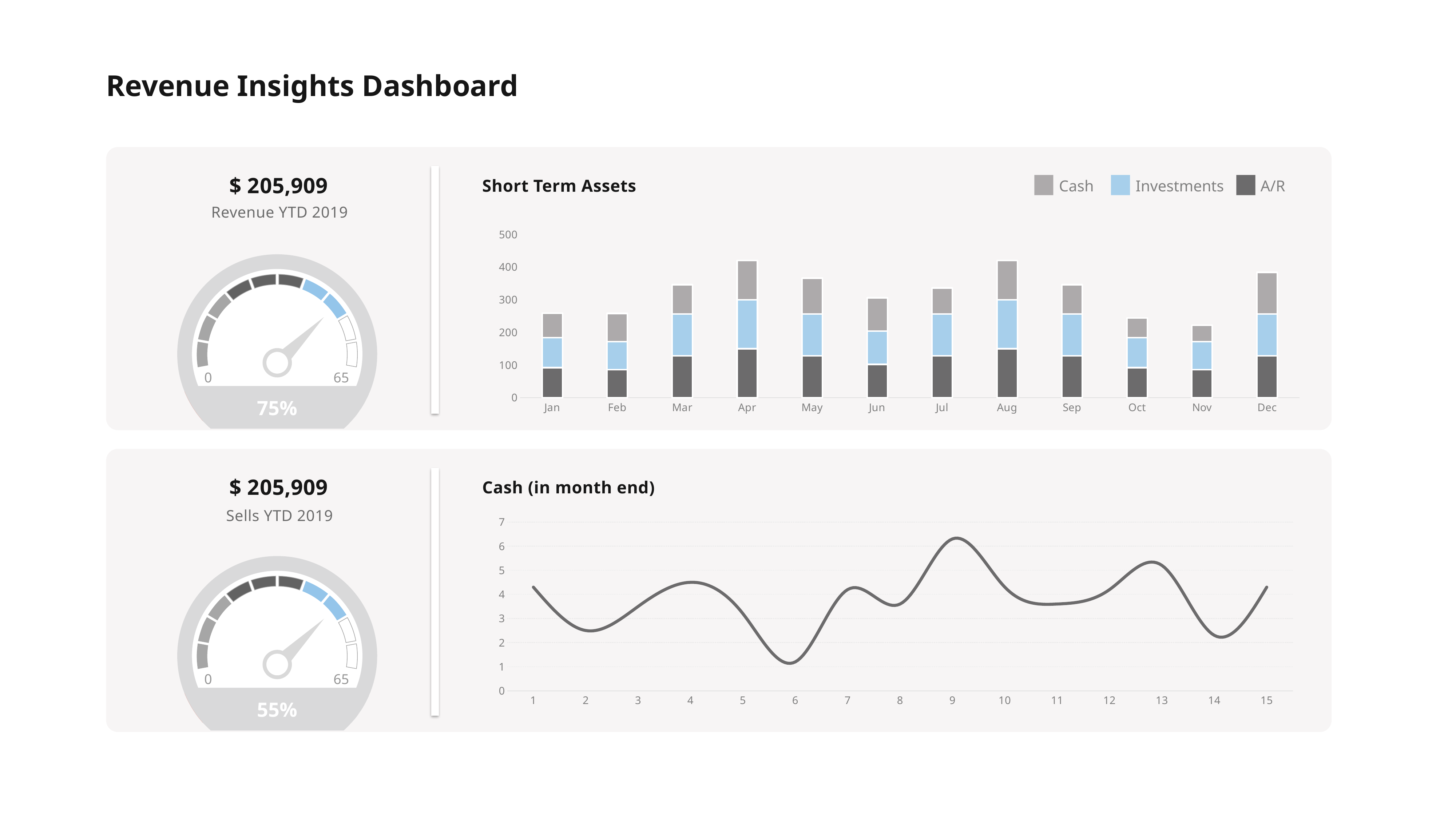
In the "Cash (in month end)" chart, at which x-axis point is the line lowest? 6 What type of chart is the "Short Term Assets" chart? stacked bar chart In the "Short Term Assets" chart, is the total stacked value for Nov greater or less than 300? less In the "Cash (in month end)" chart, is the value at point 14 greater or less than 3? less In the "Short Term Assets" chart, which series is shown in light blue? Investments In the "Cash (in month end)" chart, at which x-axis point is the line highest? 9 How many points are shown on the x axis of the "Cash (in month end)" chart? 15 How many months are shown on the x axis of the "Short Term Assets" chart? 12 What type of chart is the "Cash (in month end)" chart? line chart In the "Short Term Assets" chart, which month has the taller stacked bar, Apr or Nov? Apr How many series does the legend of the "Short Term Assets" chart list? 3 In the "Short Term Assets" chart, is the total stacked value for Apr greater or less than 400? greater